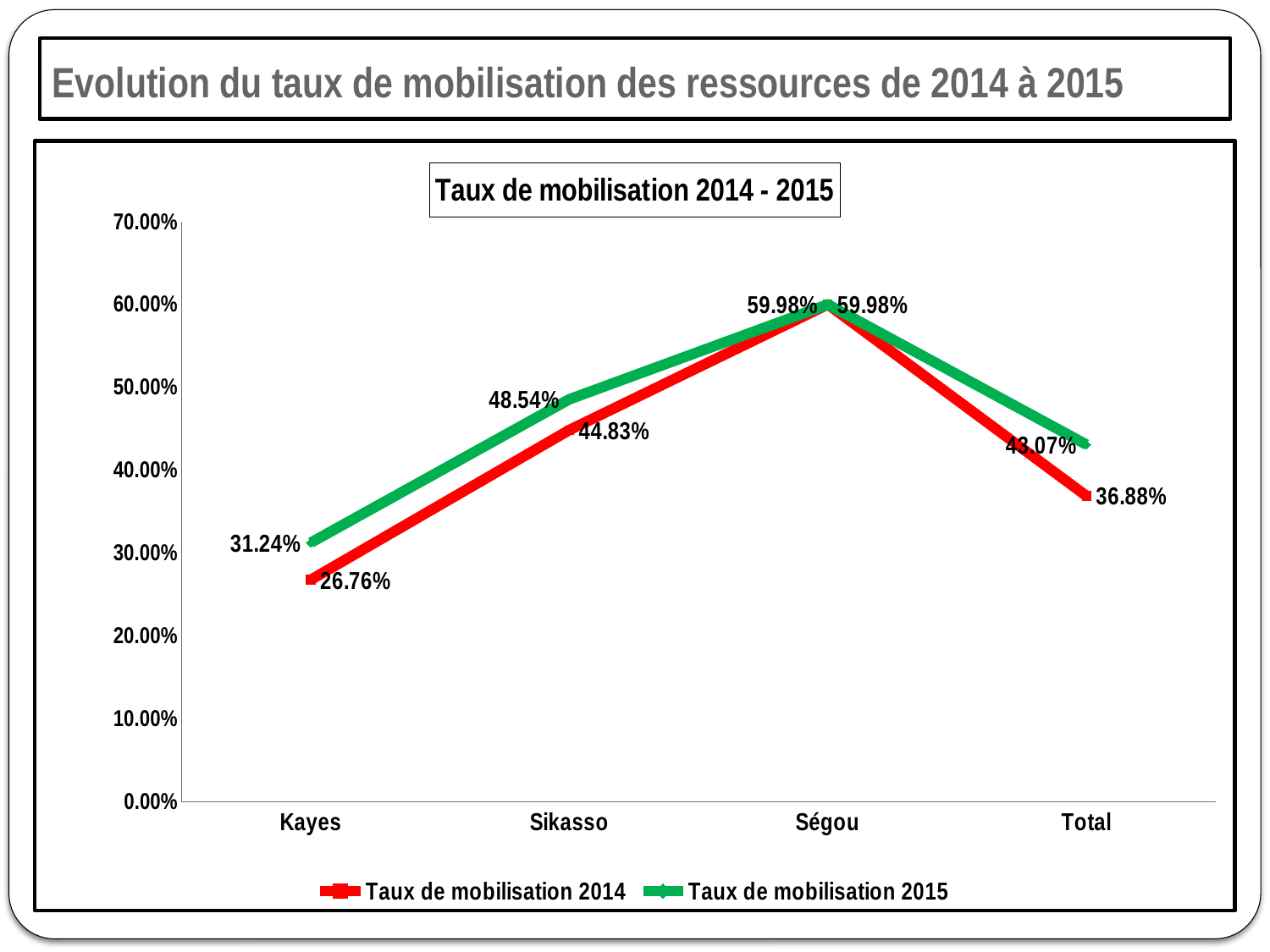
Which category has the lowest Taux de mobilisation 2015 value? Kayes What is the title of the chart? Taux de mobilisation 2014 - 2015 What is the difference between the Taux de mobilisation 2015 and Taux de mobilisation 2014 values for Total? 6.19% Which is larger for Sikasso: the Taux de mobilisation 2014 value or the Taux de mobilisation 2015 value? Taux de mobilisation 2015 How many series does the legend list? 2 What is the Taux de mobilisation 2015 value for Sikasso? 48.54% What is the Taux de mobilisation 2015 value for Total? 43.07% What type of chart is shown on the slide? line chart How many categories are shown on the x axis? 4 Which category has the highest Taux de mobilisation 2014 value? Ségou What is the Taux de mobilisation 2014 value for Kayes? 26.76% What is the Taux de mobilisation 2014 value for Ségou? 59.98%